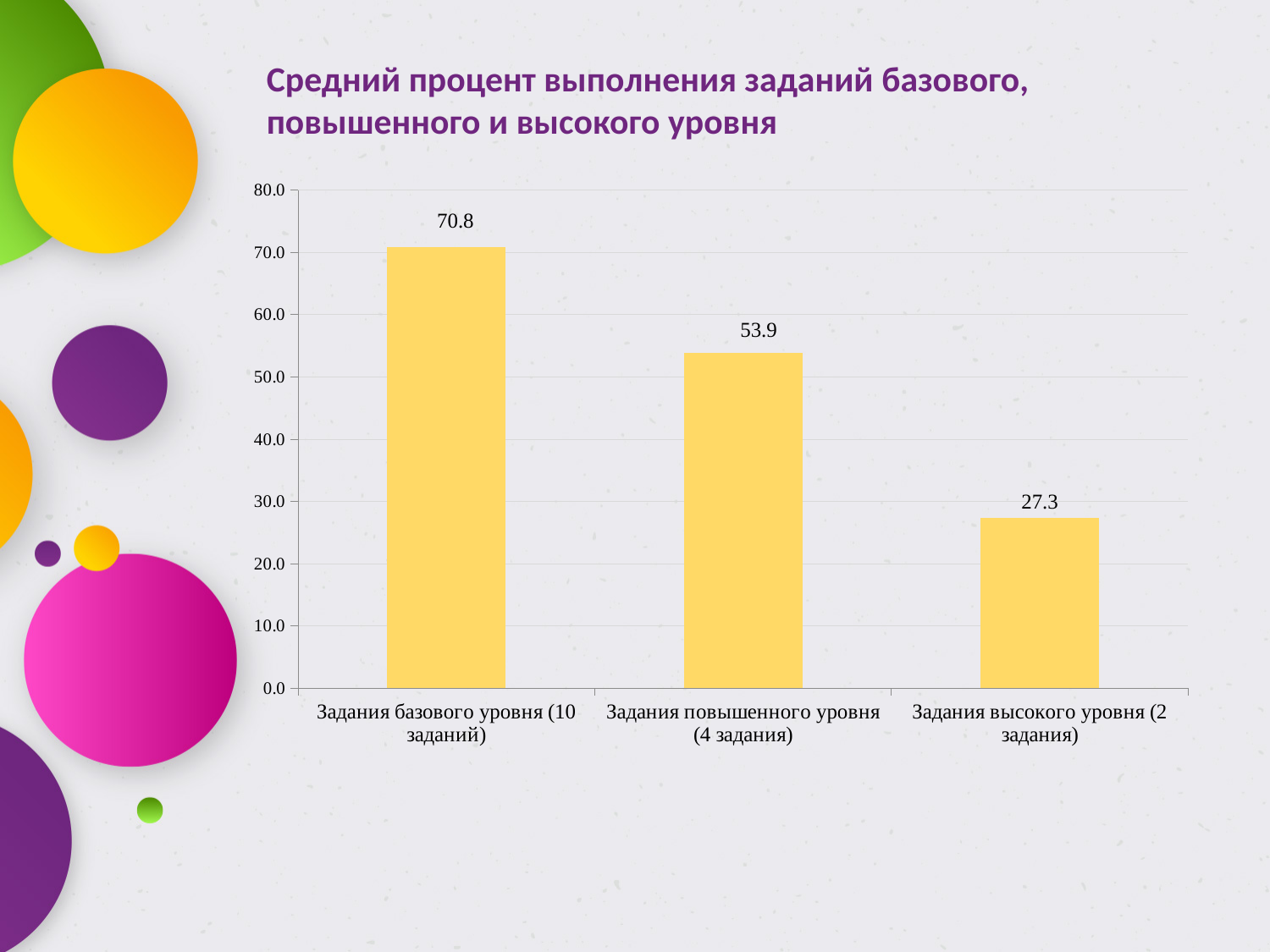
What kind of chart is shown on the slide? bar chart What is the value for Задания базового уровня (10 заданий)? 70.8 What is the difference between the values for Задания базового уровня (10 заданий) and Задания повышенного уровня (4 задания)? 16.9 How many categories are shown in the chart? 3 Which category has the highest value? Задания базового уровня (10 заданий) Which category has the lowest value? Задания высокого уровня (2 задания) What is the value for Задания повышенного уровня (4 задания)? 53.9 Which is larger: the value for Задания повышенного уровня (4 задания) or Задания высокого уровня (2 задания)? Задания повышенного уровня (4 задания) Is the value for Задания высокого уровня (2 задания) greater or less than 30.0? less What is the value for Задания высокого уровня (2 задания)? 27.3 What is the difference between the values for Задания повышенного уровня (4 задания) and Задания высокого уровня (2 задания)? 26.6 Do the values rise or fall from left to right along the x axis? fall